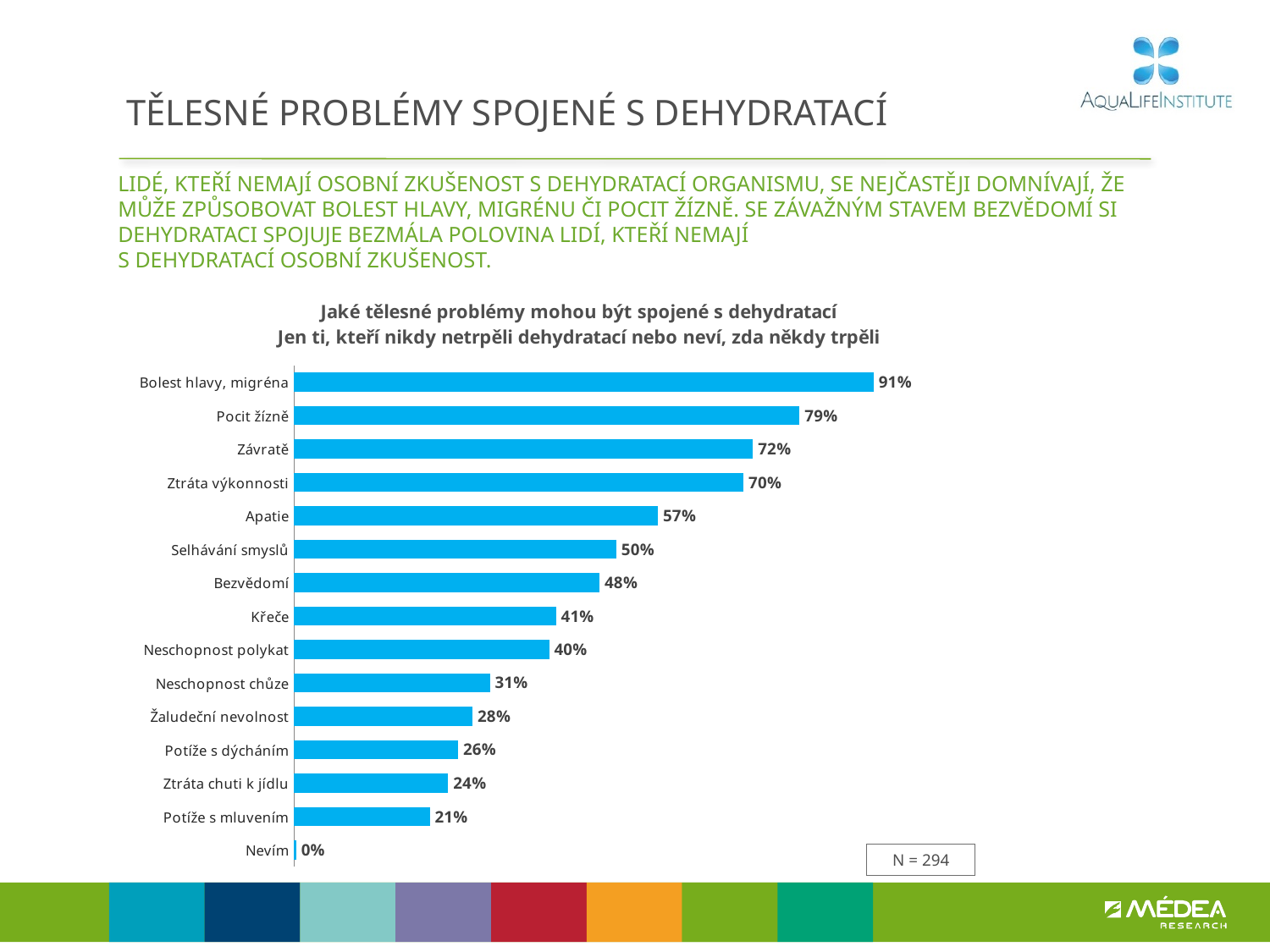
Which is larger, the value for Apatie or the value for Selhávání smyslů? Apatie What is the difference between the values for Křeče and Neschopnost polykat? 1% What kind of chart is shown on the slide? Bar chart What sample size (N) is shown on the chart? N = 294 What is the difference between the values for Pocit žízně and Závratě? 7% Which category has the lowest value? Nevím What is the value for Potíže s mluvením? 21% Which category has the highest value? Bolest hlavy, migréna What is the value for Žaludeční nevolnost? 28% How many categories are shown in the chart? 15 What is the value for Bezvědomí? 48% What is the value for Bolest hlavy, migréna? 91%